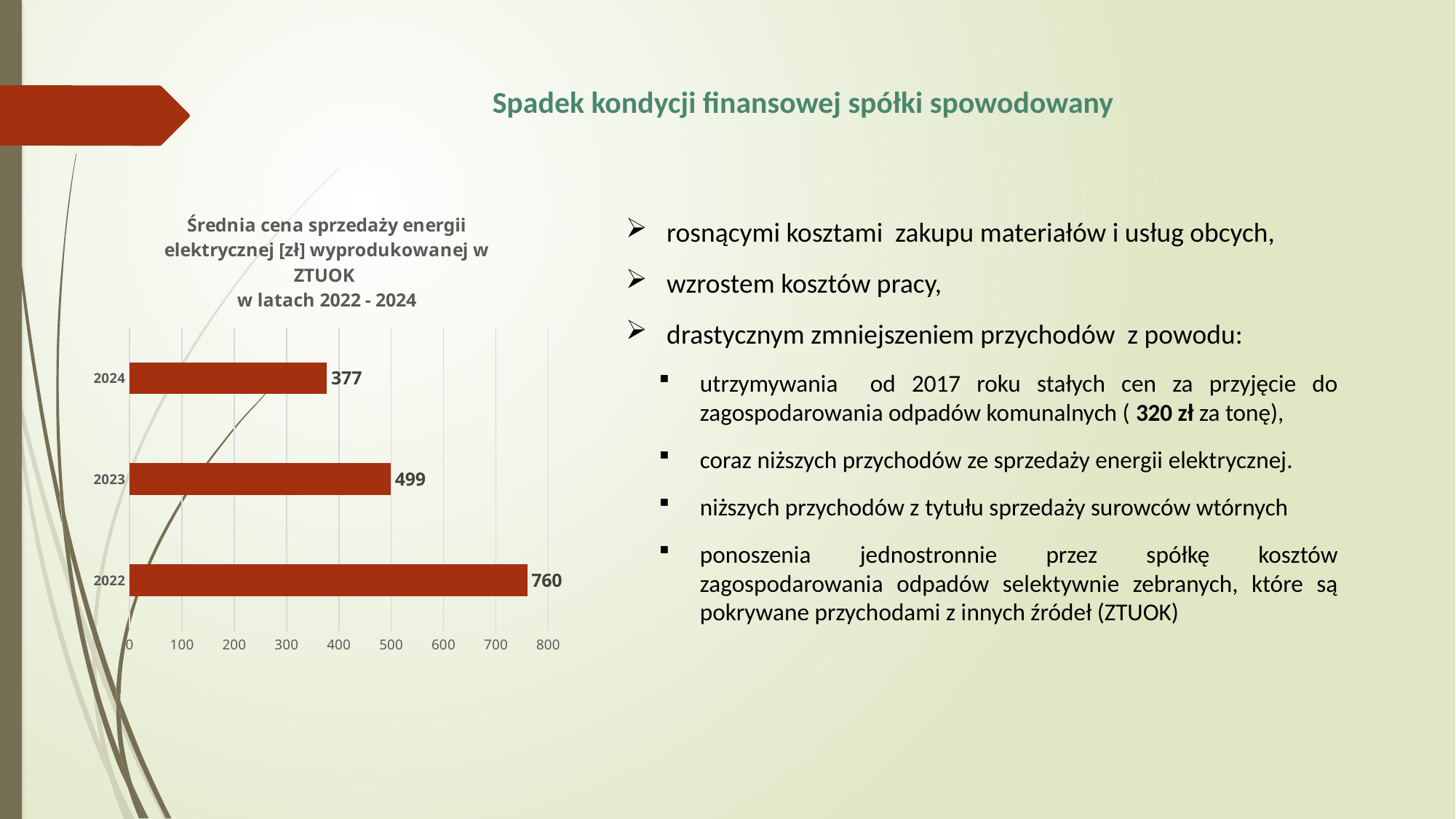
What kind of chart is shown on the slide? bar chart Do the values rise or fall from 2022 to 2024? fall Is the value for 2023 greater or less than 400? greater What is the average electricity sale price shown for 2023? 499 Which year has the highest average electricity sale price? 2022 How many years are shown in the chart? 3 What is the average electricity sale price shown for 2024? 377 What is the average electricity sale price shown for 2022? 760 Which year has a larger value, 2023 or 2024? 2023 What is the difference between the 2022 and 2024 values? 383 Which year has the lowest average electricity sale price? 2024 What is the difference between the 2023 and 2024 values? 122